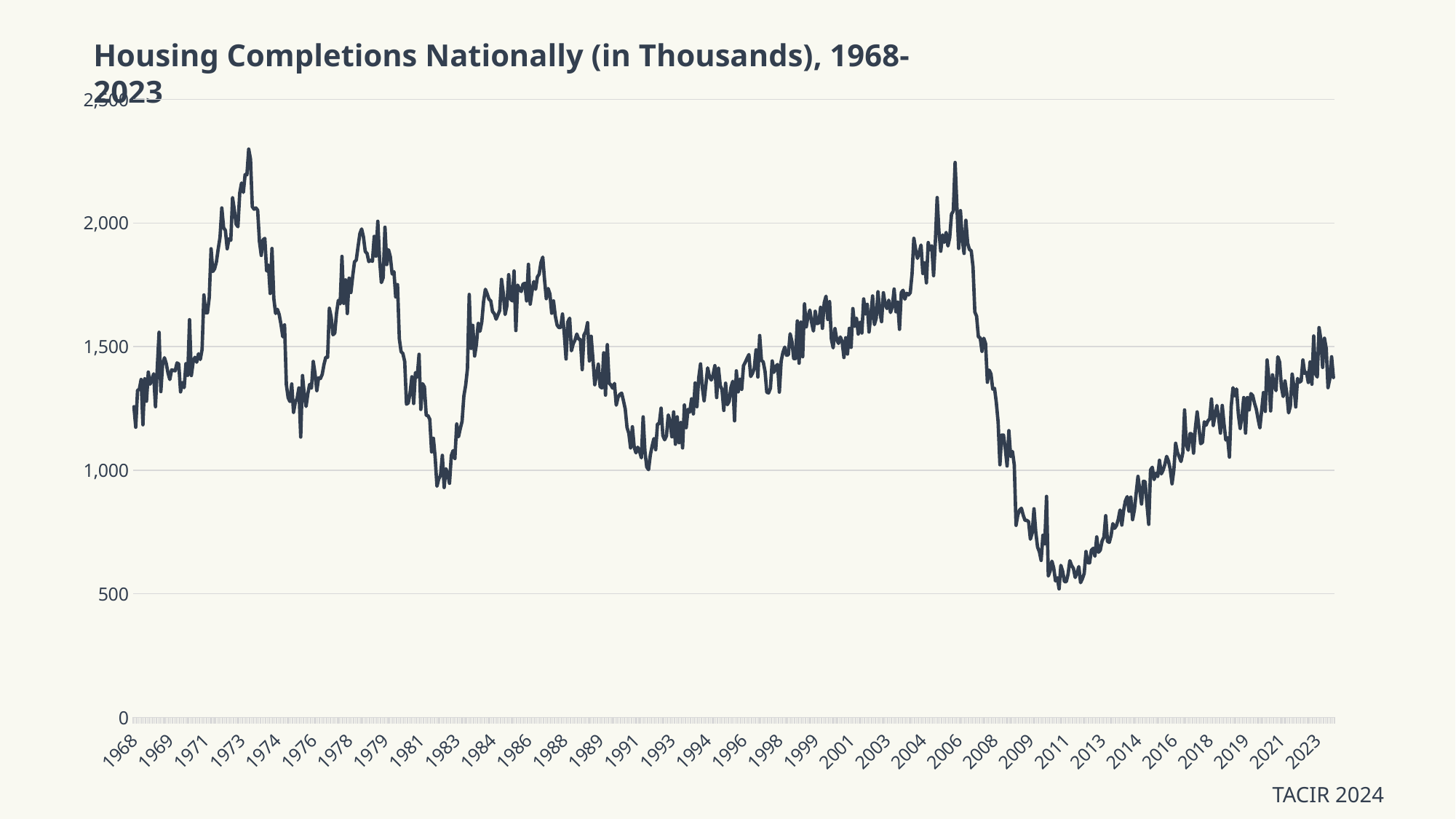
Is the value for 1973 greater or less than 2,000? greater What kind of chart is shown on the slide? line chart What is the title of the chart? Housing Completions Nationally (in Thousands), 1968-2023 Is the value for 1986 greater or less than 1,500? greater Do the values rise or fall between 2006 and 2011? fall Which is larger, the value for 1973 or the value for 2011? 1973 Is the value for 2009 greater or less than 1,000? less In which year does the line reach its lowest point? 2011 Do the values rise or fall between 2011 and 2023? rise